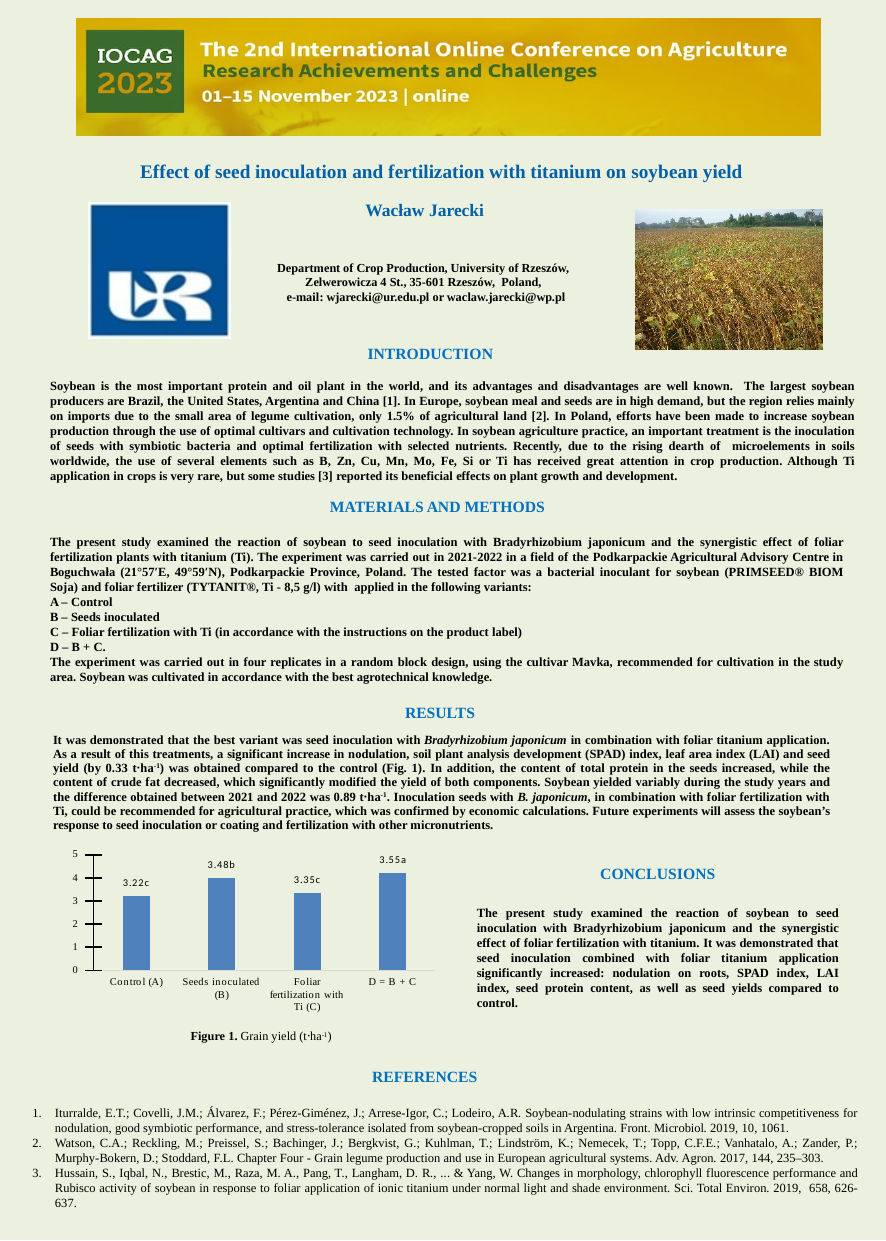
What is the grain yield value shown for Foliar fertilization with Ti (C) in Figure 1? 3.35c Is the grain yield for Control (A) in Figure 1 greater or less than 4? less Which variant has the highest grain yield in Figure 1? D = B + C Which has the larger grain yield in Figure 1, Seeds inoculated (B) or Foliar fertilization with Ti (C)? Seeds inoculated (B) How many variants (bars) are shown in Figure 1? 4 What is the grain yield value shown for D = B + C in Figure 1? 3.55a What type of chart is Figure 1? bar chart What is the caption of the chart on the slide? Figure 1. Grain yield (t·ha⁻¹) What is the grain yield value shown for Seeds inoculated (B) in Figure 1? 3.48b What is the grain yield value shown for Control (A) in Figure 1? 3.22c Which variant has the lowest grain yield in Figure 1? Control (A) What is the difference in grain yield between D = B + C and Control (A) in Figure 1? 0.33